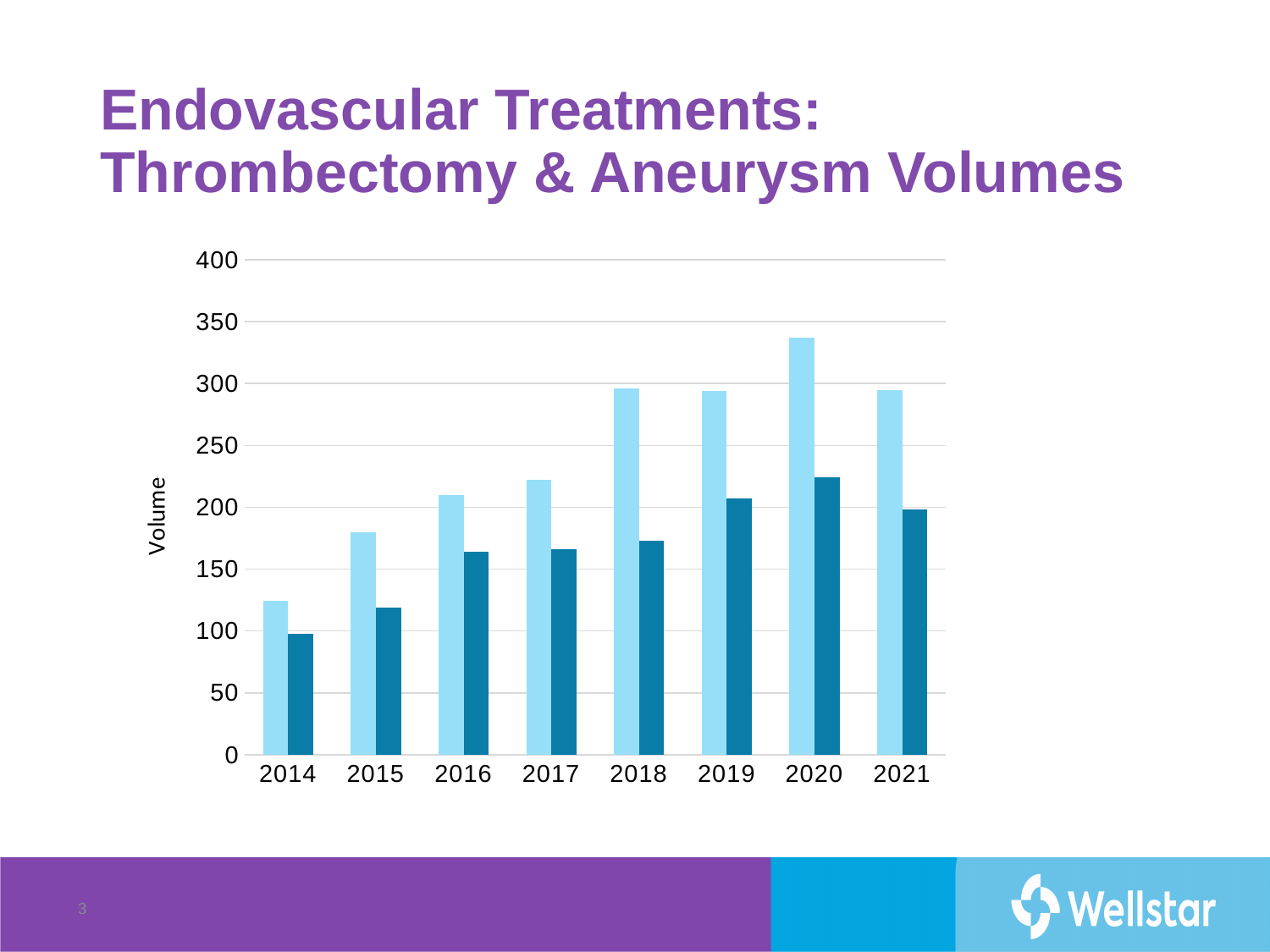
Which is larger in 2018, the light blue bar or the dark blue bar? the light blue bar Do the light blue bars generally rise or fall from 2014 to 2020? rise In which year is the light blue bar the shortest? 2014 What is the label on the vertical axis of the chart? Volume What is the title of the slide containing the chart? Endovascular Treatments: Thrombectomy & Aneurysm Volumes Is the value of the light blue bar for 2018 greater or less than 250? greater How many years are shown on the x axis of the chart? 8 In which year is the light blue bar the tallest? 2020 Is the value of the dark blue bar for 2014 greater or less than 150? less In which year is the dark blue bar the shortest? 2014 What kind of chart is shown on the slide? bar chart Is the value of the light blue bar for 2020 greater or less than 300? greater